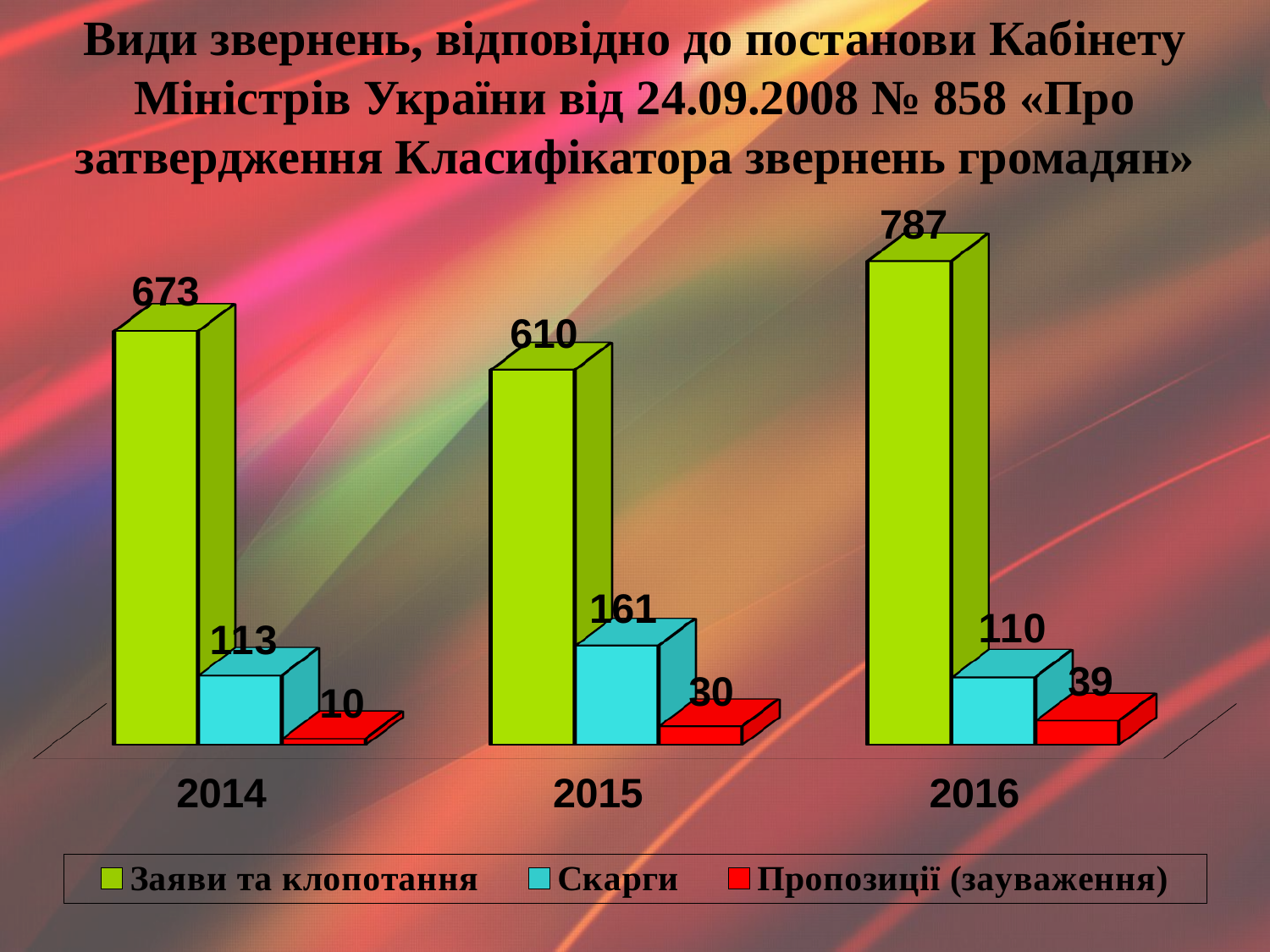
Does the value for Скарги rise or fall from 2015 to 2016? Fall Which is larger: Скарги in 2014 or Скарги in 2016? Скарги in 2014 Which colour represents Пропозиції (зауваження) in the legend? Red What is the difference between the Заяви та клопотання values for 2016 and 2015? 177 What kind of chart is shown on the slide? Bar chart What is the value for Пропозиції (зауваження) in 2016? 39 How many series does the legend list? 3 In which year is the value for Заяви та клопотання highest? 2016 What is the value for Скарги in 2015? 161 How many years are shown on the x axis? 3 In which year is the value for Пропозиції (зауваження) lowest? 2014 What is the value for Заяви та клопотання in 2014? 673